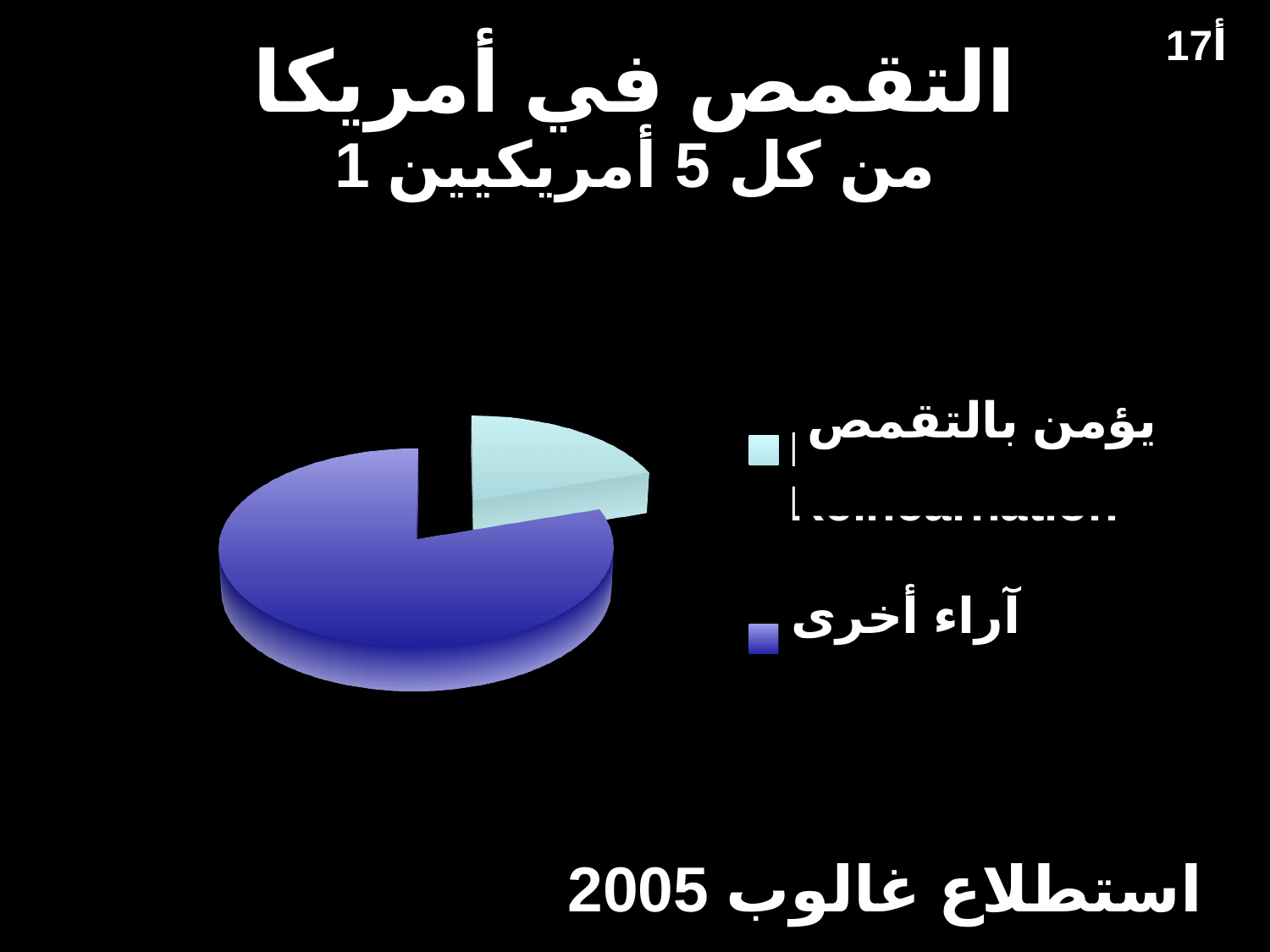
Which category has the largest slice in the pie chart? آراء أخرى How many entries does the legend of the pie chart list? 2 What kind of chart is shown on the slide? pie chart How many slices does the pie chart have? 2 Which category has the smallest slice in the pie chart? يؤمن بالتقمص What is the title of the slide containing the pie chart? التقمص في أمريكا Which slice is larger: يؤمن بالتقمص or آراء أخرى? آراء أخرى What colour is the slice for يؤمن بالتقمص in the pie chart? light cyan